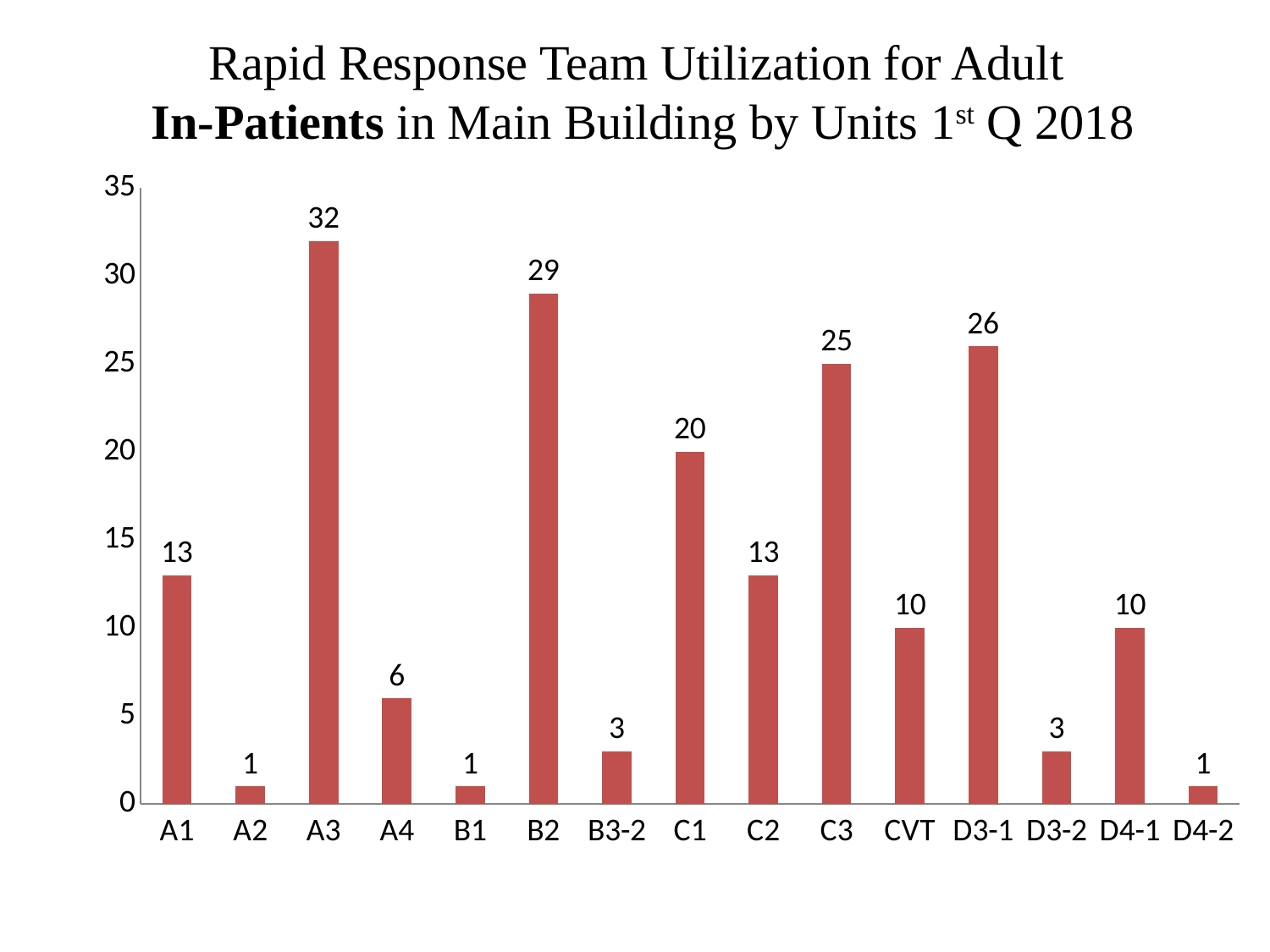
Which is larger, the value for C1 or the value for D3-1? D3-1 What is the value for unit A3? 32 Which unit has the highest value? A3 Is the value for C2 greater or less than 15? less What is the difference between the values for B2 and C3? 4 What kind of chart is shown on the slide? bar chart Which units have a value of 1? A2, B1, D4-2 How many units are shown on the x axis? 15 What is the highest value shown on the y axis? 35 What is the value for unit B3-2? 3 What is the difference between the values for A3 and A4? 26 What is the value for unit CVT? 10